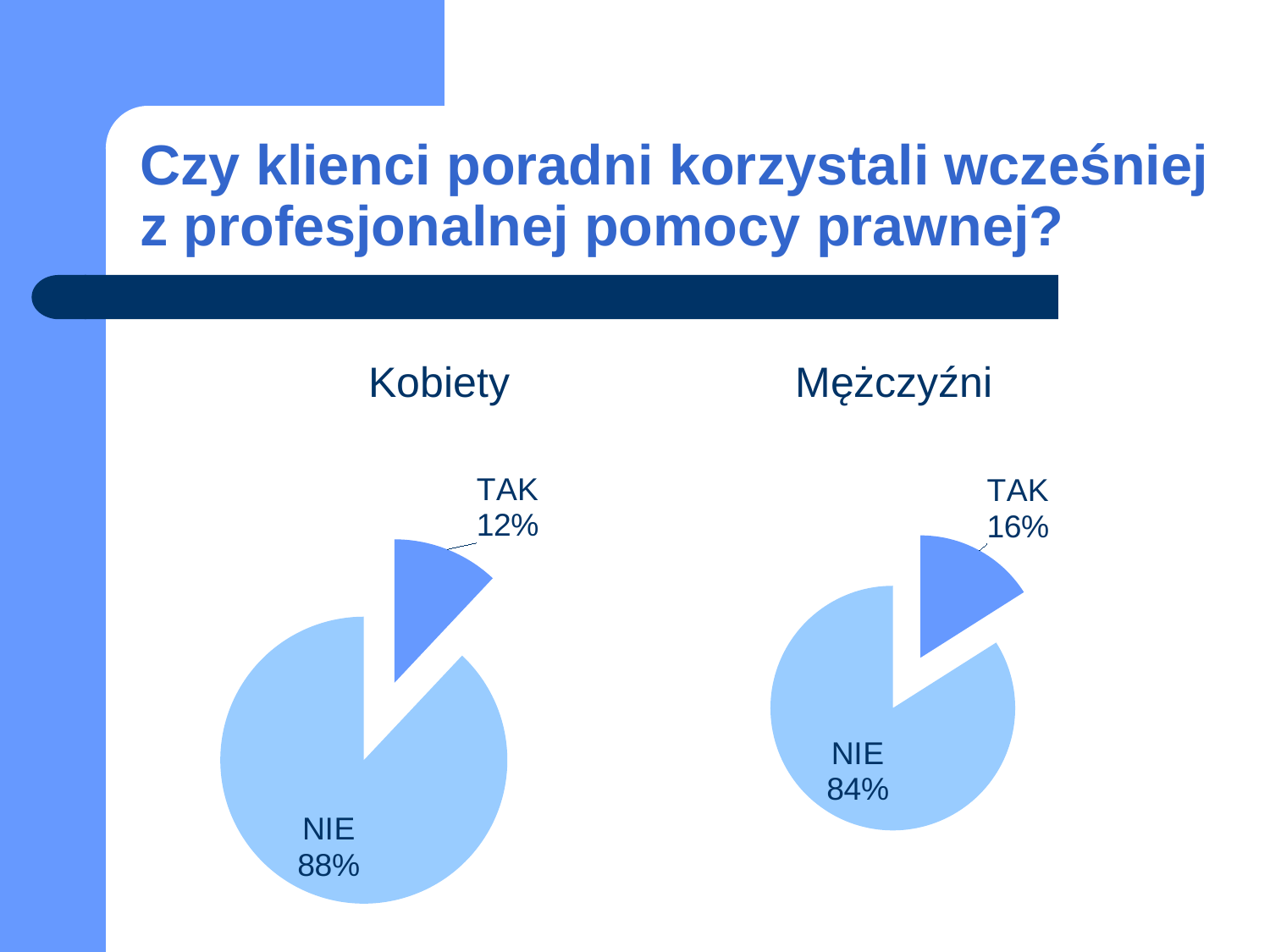
What type of chart is used for Kobiety and Mężczyźni on this slide? Pie chart What is the difference between the NIE and TAK shares in the Kobiety pie chart? 76% In the Mężczyźni pie chart, what share is labelled TAK? 16% In the Kobiety pie chart, which slice is the largest? NIE In the Kobiety pie chart, what share is labelled NIE? 88% How many pie charts are shown on the slide? 2 Which is larger: the TAK share in the Kobiety chart or the TAK share in the Mężczyźni chart? Mężczyźni In the Kobiety pie chart, what share is labelled TAK? 12% In the Mężczyźni pie chart, which slice is the smallest? TAK How many slices does the Mężczyźni pie chart have? 2 What is the title of the slide above the two pie charts? Czy klienci poradni korzystali wcześniej z profesjonalnej pomocy prawnej? In the Mężczyźni pie chart, what share is labelled NIE? 84%